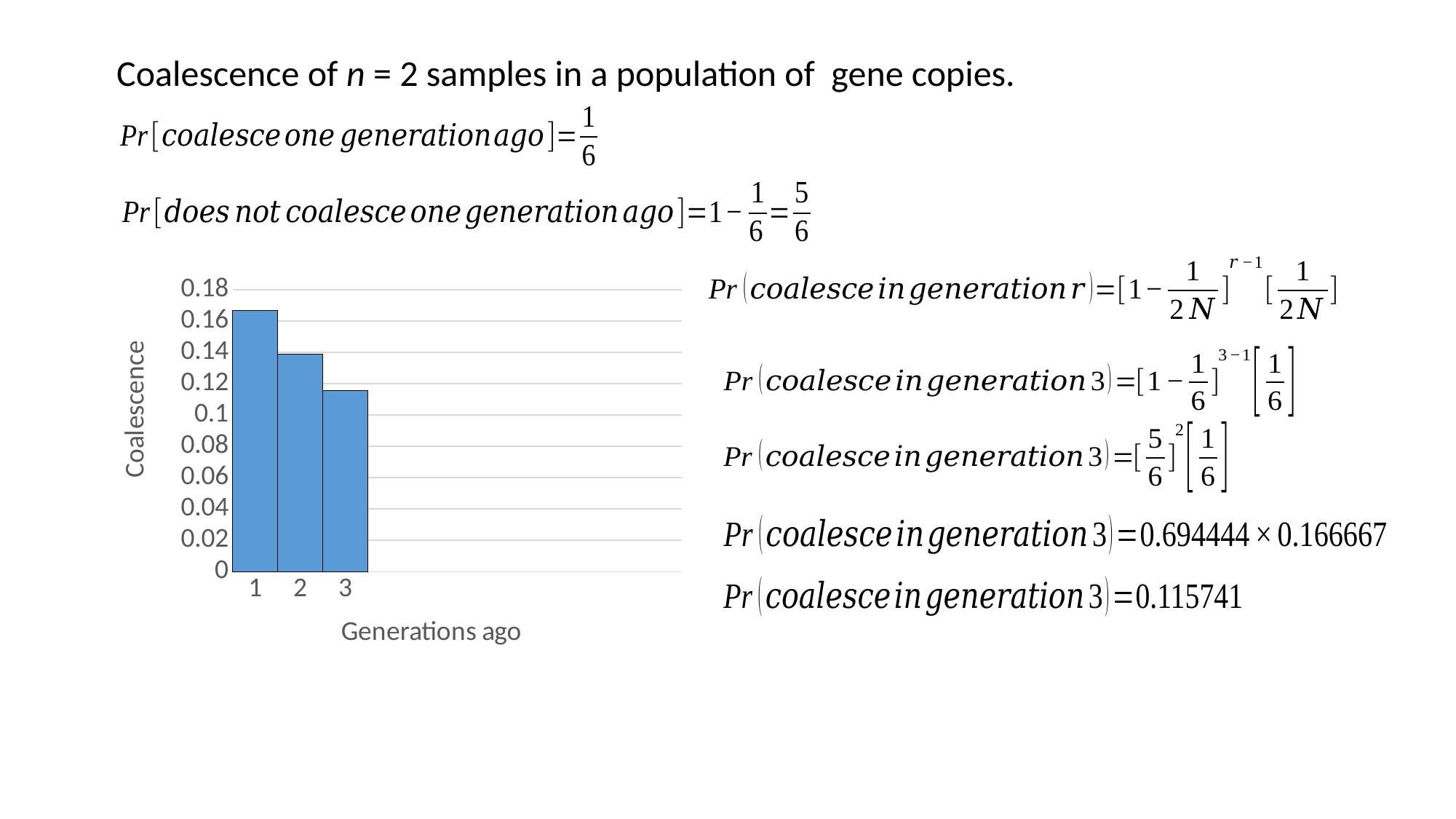
Is the Coalescence value for 1 generation ago greater or less than 0.14? greater Which bar is taller: 1 generation ago or 3 generations ago? 1 generation ago What kind of chart is shown on the slide? bar chart Is the Coalescence value for 3 generations ago greater or less than 0.1? greater Is the Coalescence value for 3 generations ago greater or less than 0.14? less What is the label of the horizontal axis of the chart? Generations ago Which value of Generations ago has the highest Coalescence bar? 1 What is the label of the vertical axis of the chart? Coalescence Which value of Generations ago has the lowest Coalescence bar? 3 Do the bar heights rise or fall as Generations ago increases from 1 to 3? fall How many bars are plotted in the chart? 3